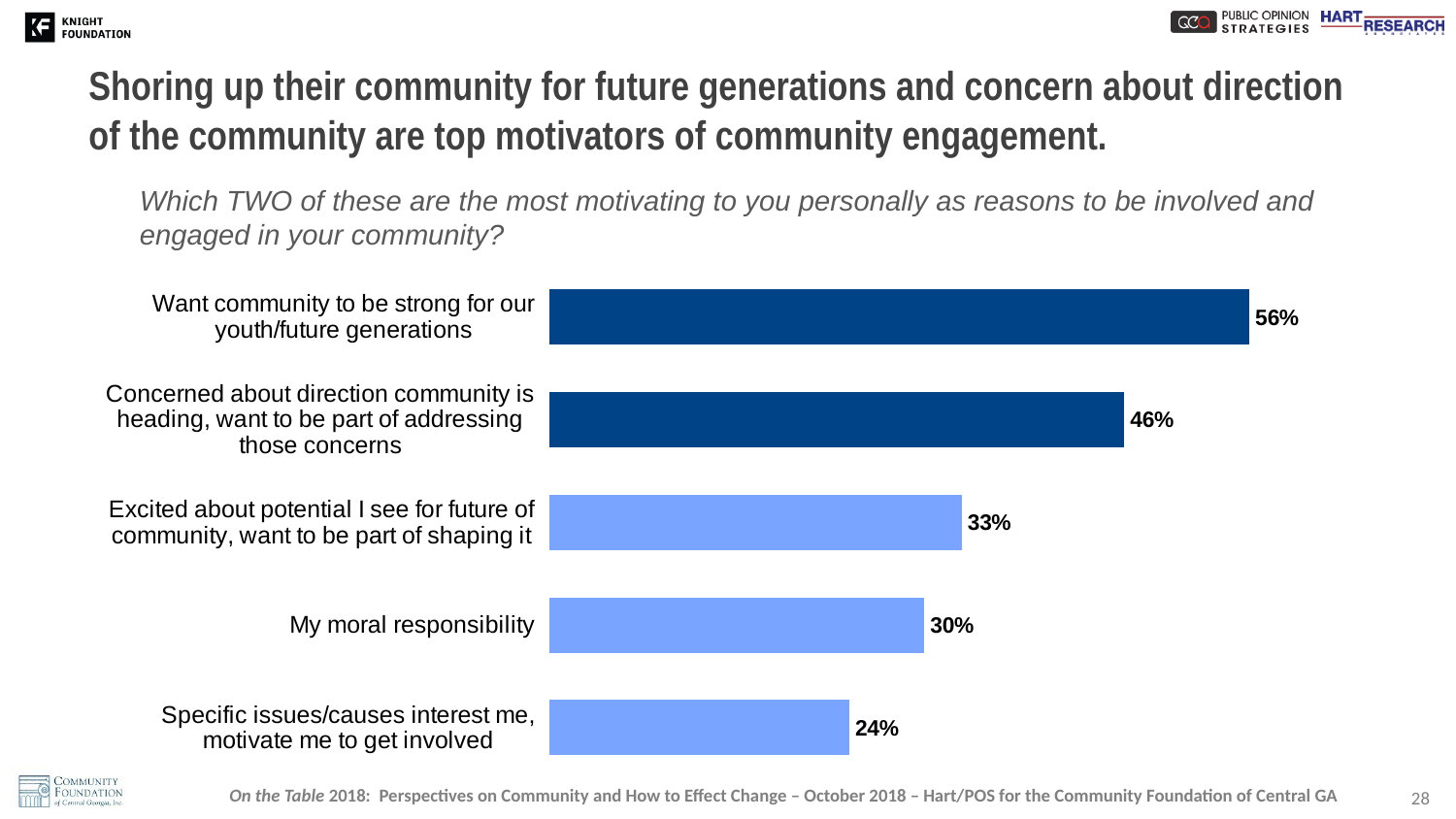
What percentage is shown for "Specific issues/causes interest me, motivate me to get involved"? 24% What percentage of respondents chose "Want community to be strong for our youth/future generations" as a top motivator? 56% Which reason has the highest percentage on the chart? Want community to be strong for our youth/future generations How many bars on the chart are shown in dark blue? 2 What is the difference in percentage points between "Excited about potential I see for future of community" and "My moral responsibility"? 3 What type of chart is shown on the slide? Bar chart What value is shown for "My moral responsibility"? 30% What percentage chose "Concerned about direction community is heading, want to be part of addressing those concerns"? 46% Which has a larger value: "My moral responsibility" or "Specific issues/causes interest me"? My moral responsibility How many reasons (categories) are shown on the chart? 5 What is the difference in percentage points between "Want community to be strong for our youth/future generations" and "Concerned about direction community is heading"? 10 Which reason has the lowest percentage on the chart? Specific issues/causes interest me, motivate me to get involved